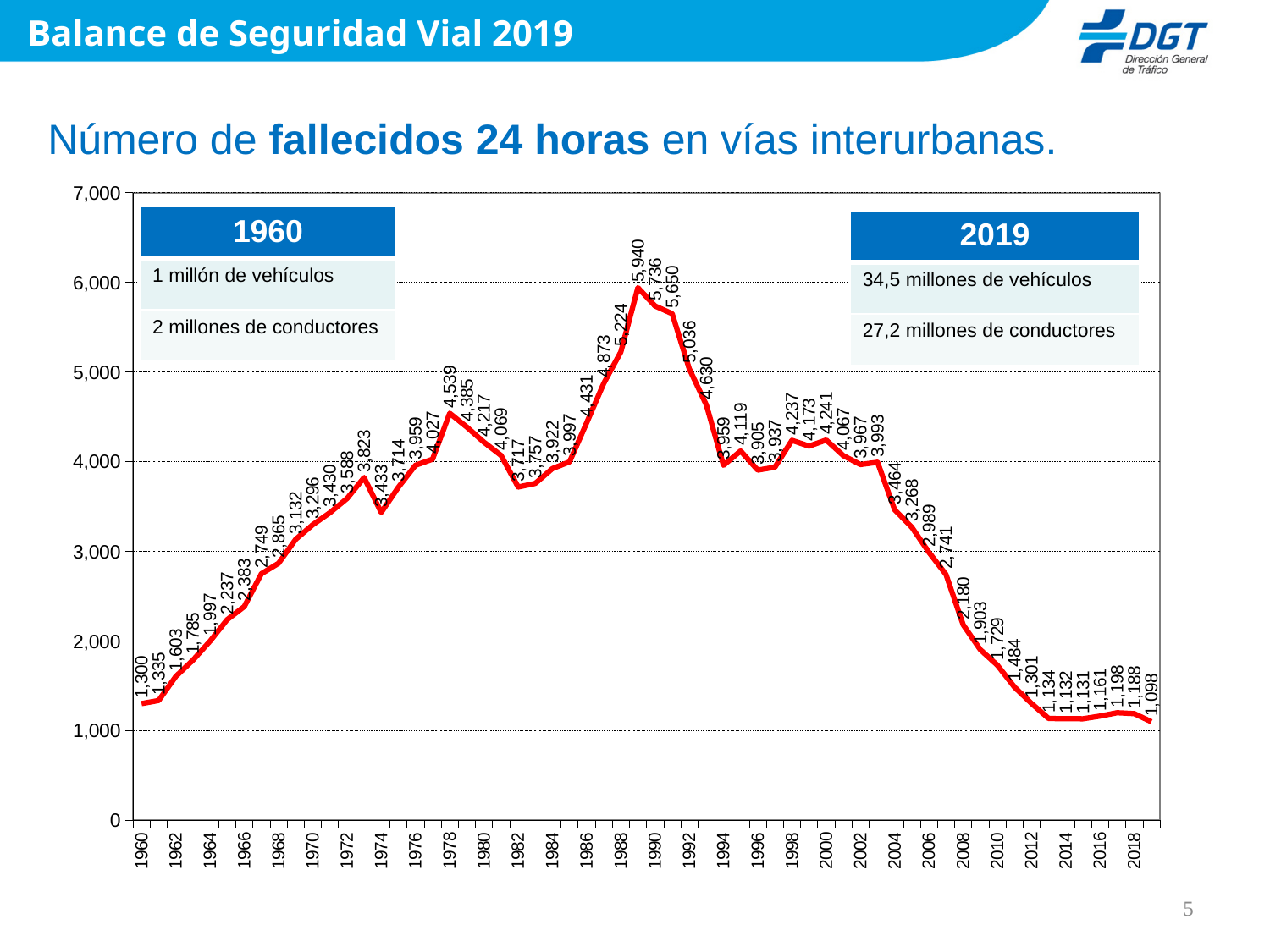
What is the value plotted for 1960? 1,300 How many years are plotted on the x axis, from 1960 to 2019? 60 Which year has the larger value, 1978 or 2000? 1978 According to the text box on the chart, how many millions of vehicles were there in 2019? 34,5 millones de vehículos What kind of chart is shown on the slide? line chart What is the number of fallecidos 24 horas en vías interurbanas in 1989? 5,940 Do the values rise or fall from 2003 to 2019? fall Is the value for 2008 greater or less than 2,000? greater In which year does the line reach its lowest value? 2019 In which year does the line reach its highest value? 1989 What is the difference between the 1989 value and the 2019 value? 4,842 What is the value plotted for 2019? 1,098